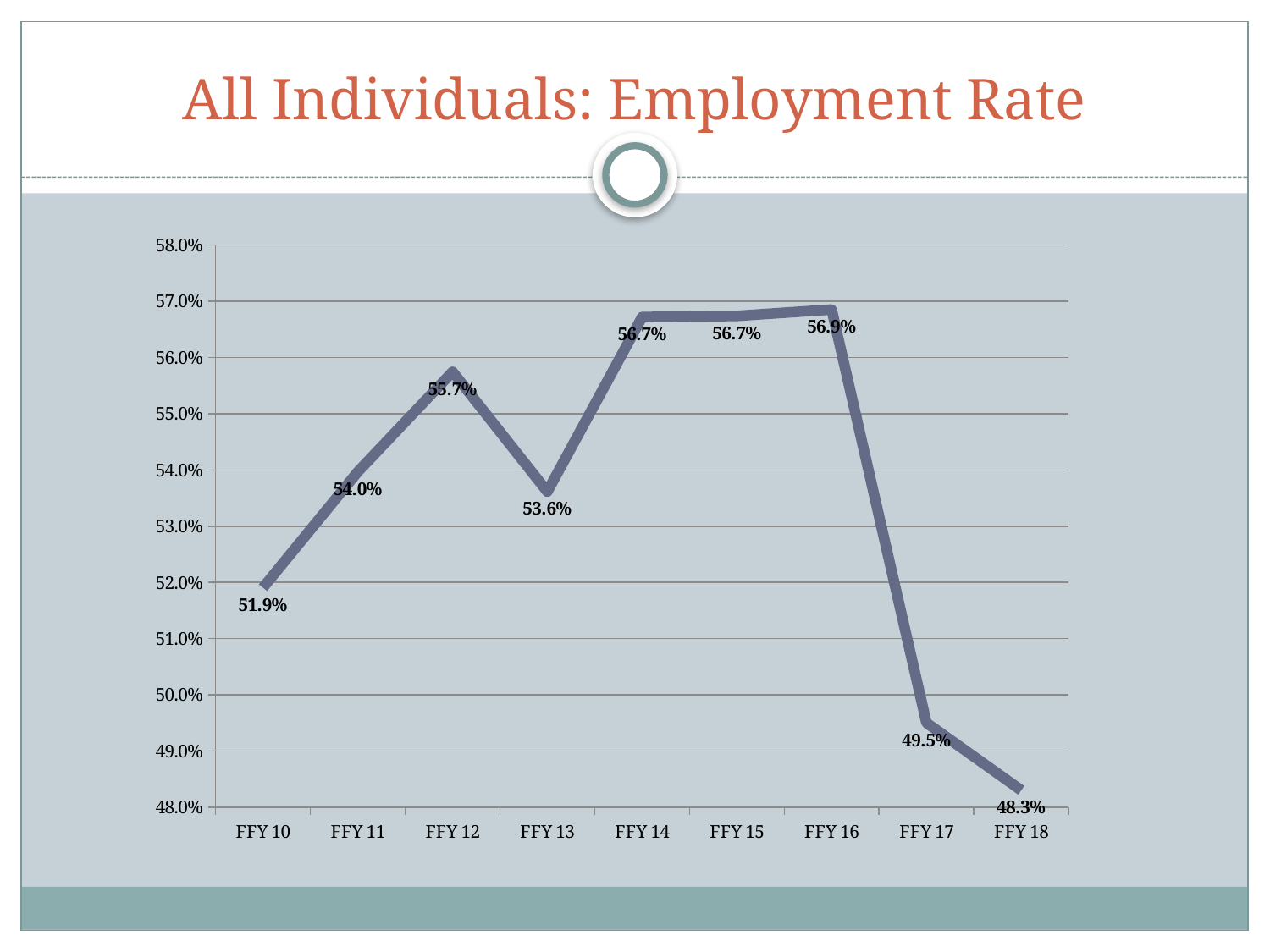
How many fiscal years are plotted on the chart? 9 Is the employment rate for FFY 17 greater or less than 50.0%? less What is the employment rate for FFY 13? 53.6% Which is larger, the employment rate in FFY 11 or FFY 13? FFY 11 What kind of chart is shown on the slide? line chart What is the employment rate for FFY 18? 48.3% Does the employment rate rise or fall from FFY 16 to FFY 18? fall Which fiscal year has the highest employment rate? FFY 16 What is the difference between the employment rate in FFY 12 and FFY 13? 2.1% What is the employment rate for FFY 10? 51.9% Which fiscal year has the lowest employment rate? FFY 18 What is the difference between the employment rate in FFY 16 and FFY 17? 7.4%